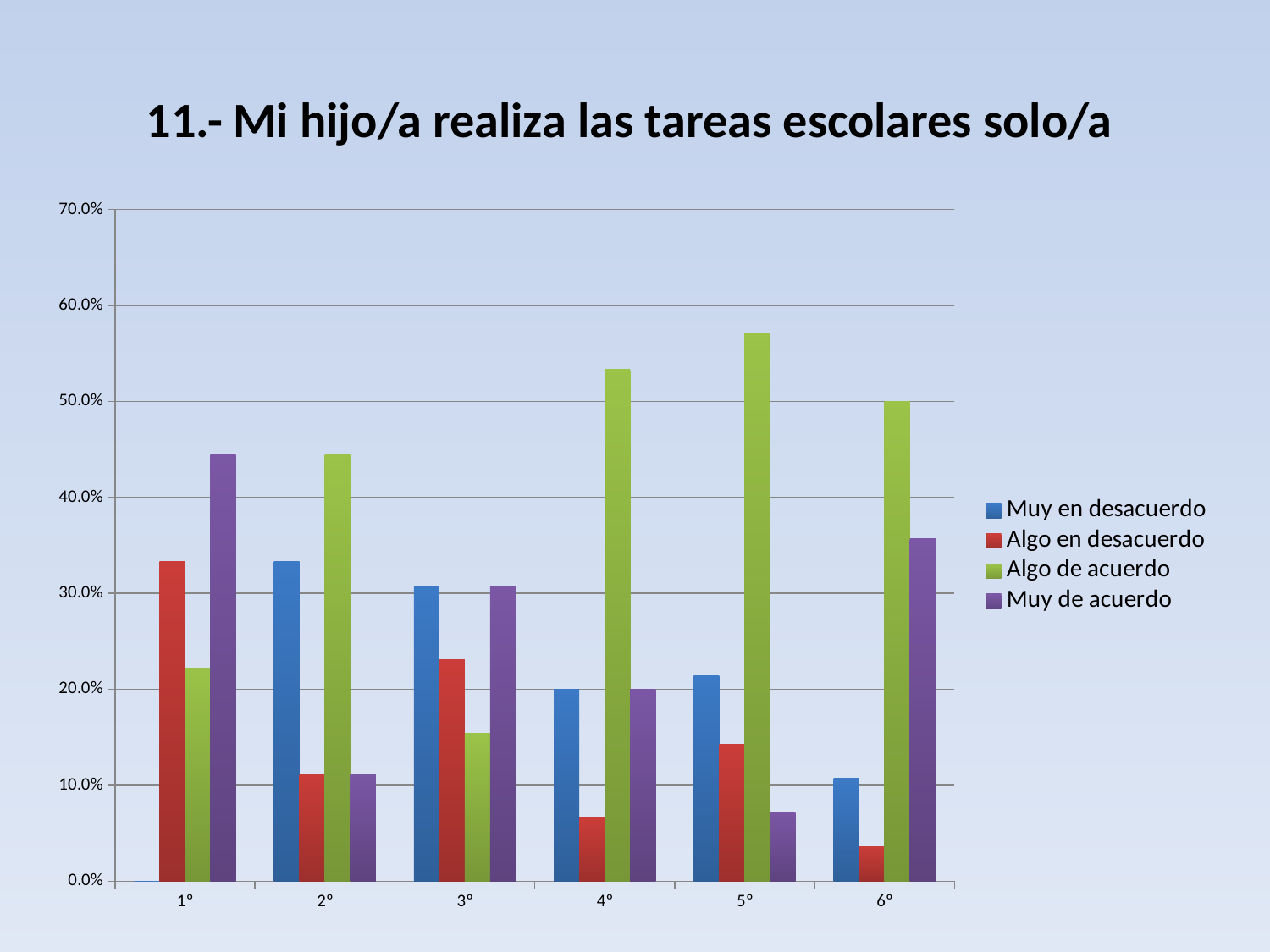
What is the title of the chart? 11.- Mi hijo/a realiza las tareas escolares solo/a What kind of chart is shown on the slide? bar chart In 3°, which is larger: Muy en desacuerdo or Algo en desacuerdo? Muy en desacuerdo Which category has the highest value for Algo de acuerdo? 5° How many series does the legend list? 4 How many categories are shown on the x axis? 6 Is the value for Algo en desacuerdo in 6° greater or less than 10.0%? less In 1°, which is larger: Muy de acuerdo or Algo en desacuerdo? Muy de acuerdo Which category has the lowest value for Algo en desacuerdo? 6° Is the value for Muy de acuerdo in 2° greater or less than 20.0%? less Is the value for Algo de acuerdo in 5° greater or less than 50.0%? greater Does the value for Algo de acuerdo rise or fall from 3° to 5°? rise